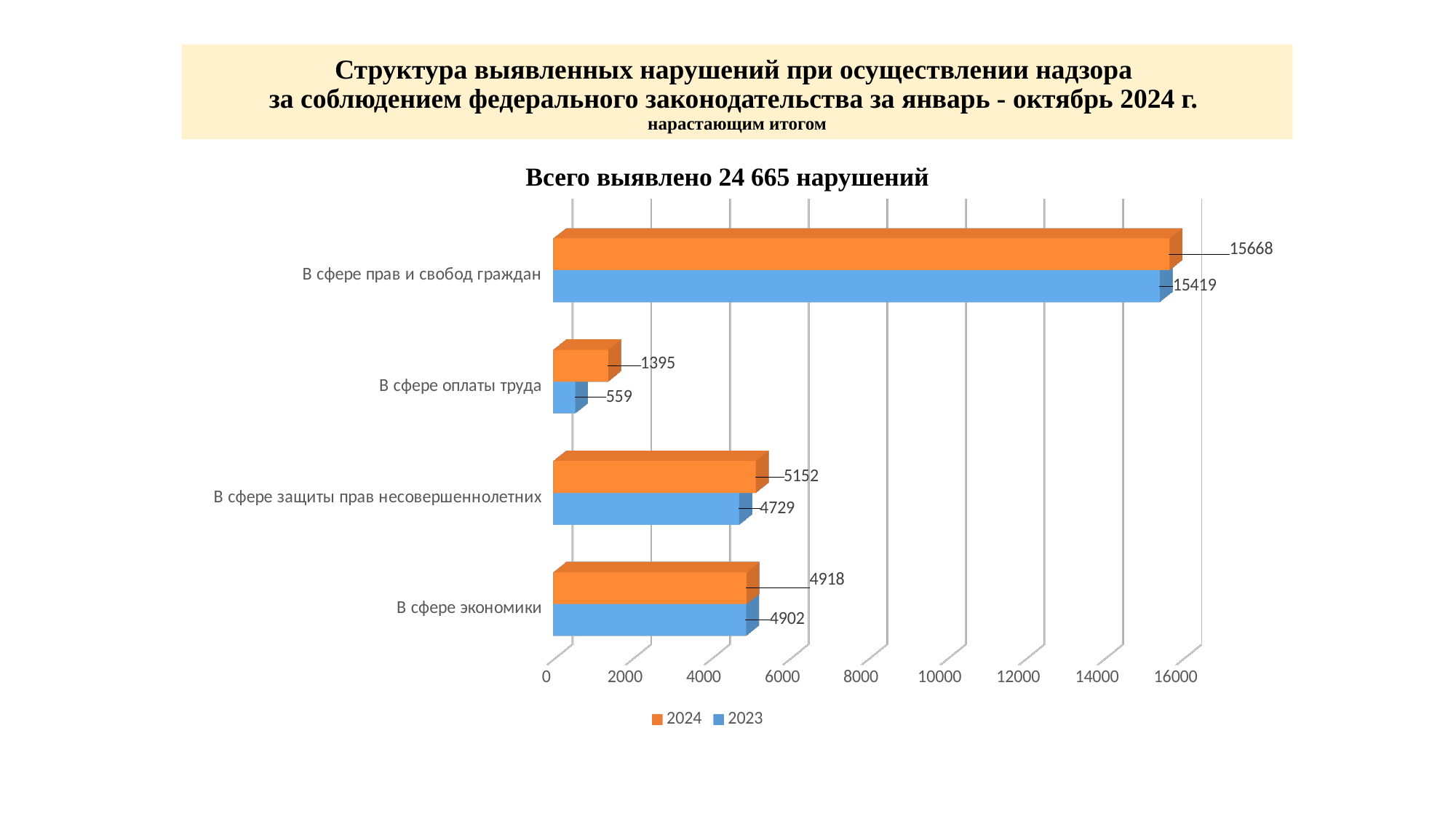
Which category has the highest 2024 value? В сфере прав и свобод граждан Which category has the lowest 2023 value? В сфере оплаты труда Which is larger for 'В сфере защиты прав несовершеннолетних': the 2024 value or the 2023 value? 2024 What is the 2024 value for 'В сфере защиты прав несовершеннолетних'? 5152 What is the difference between the 2024 and 2023 values for 'В сфере оплаты труда'? 836 What is the 2023 value for 'В сфере экономики'? 4902 How many series does the legend list? 2 What is the 2023 value for 'В сфере оплаты труда'? 559 How many categories are shown on the chart? 4 What is the 2024 value for 'В сфере прав и свобод граждан'? 15668 What total number of violations is stated in the chart title? 24 665 What kind of chart is shown on the slide? Bar chart